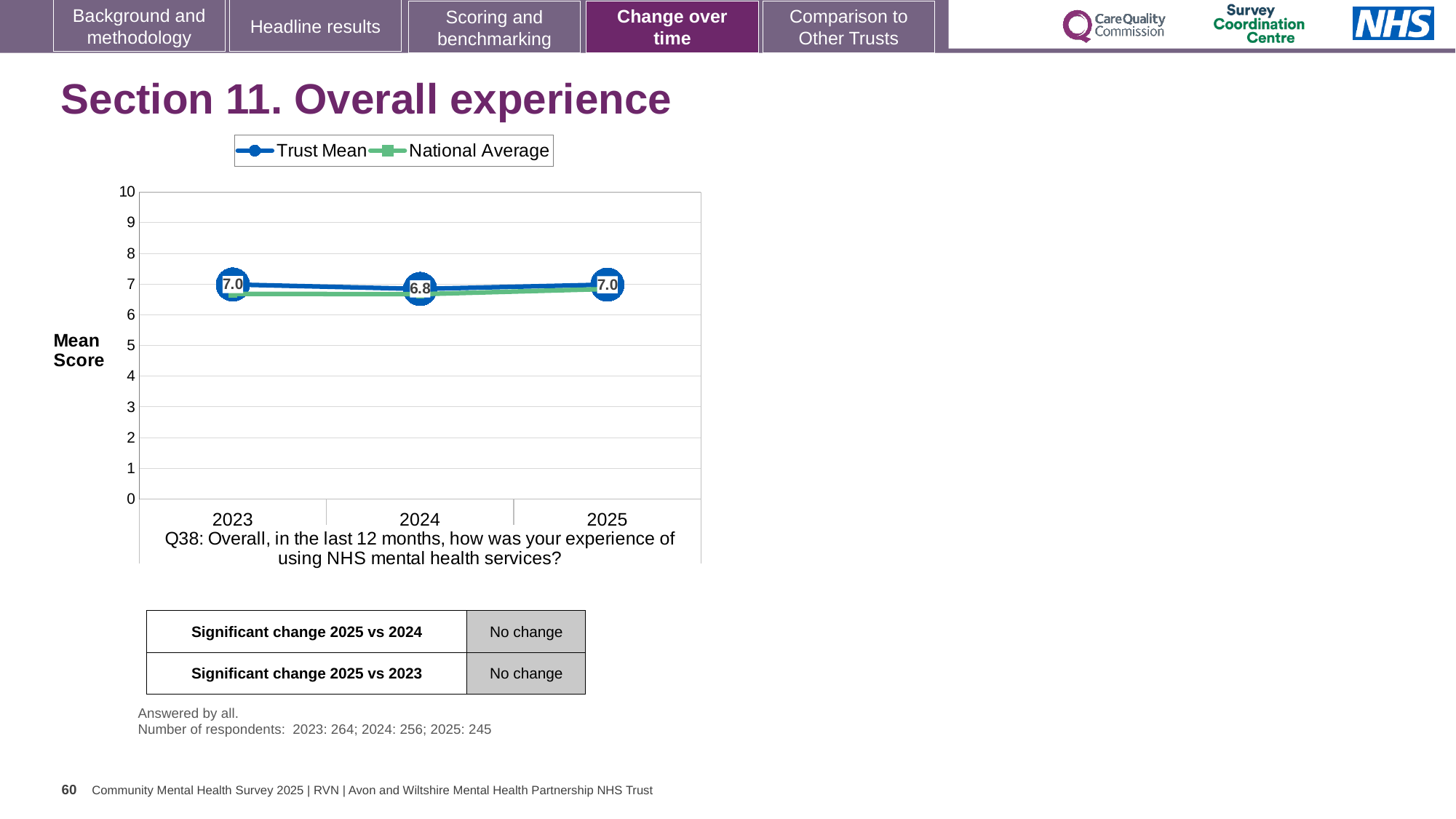
Is the National Average value for 2023 greater or less than 5? greater Is the Trust Mean value for 2024 greater or less than 6? greater Does the Trust Mean rise or fall from 2024 to 2025? Rise Which is larger, the Trust Mean for 2023 or for 2024? 2023 What kind of chart is shown on the slide? Line chart How many series does the legend list? 2 What is the Trust Mean value for 2023? 7.0 In which year is the Trust Mean lowest? 2024 What is the difference between the Trust Mean in 2023 and in 2024? 0.2 What is the Trust Mean value for 2025? 7.0 How many years are plotted on the x axis? 3 What is the Trust Mean value for 2024? 6.8